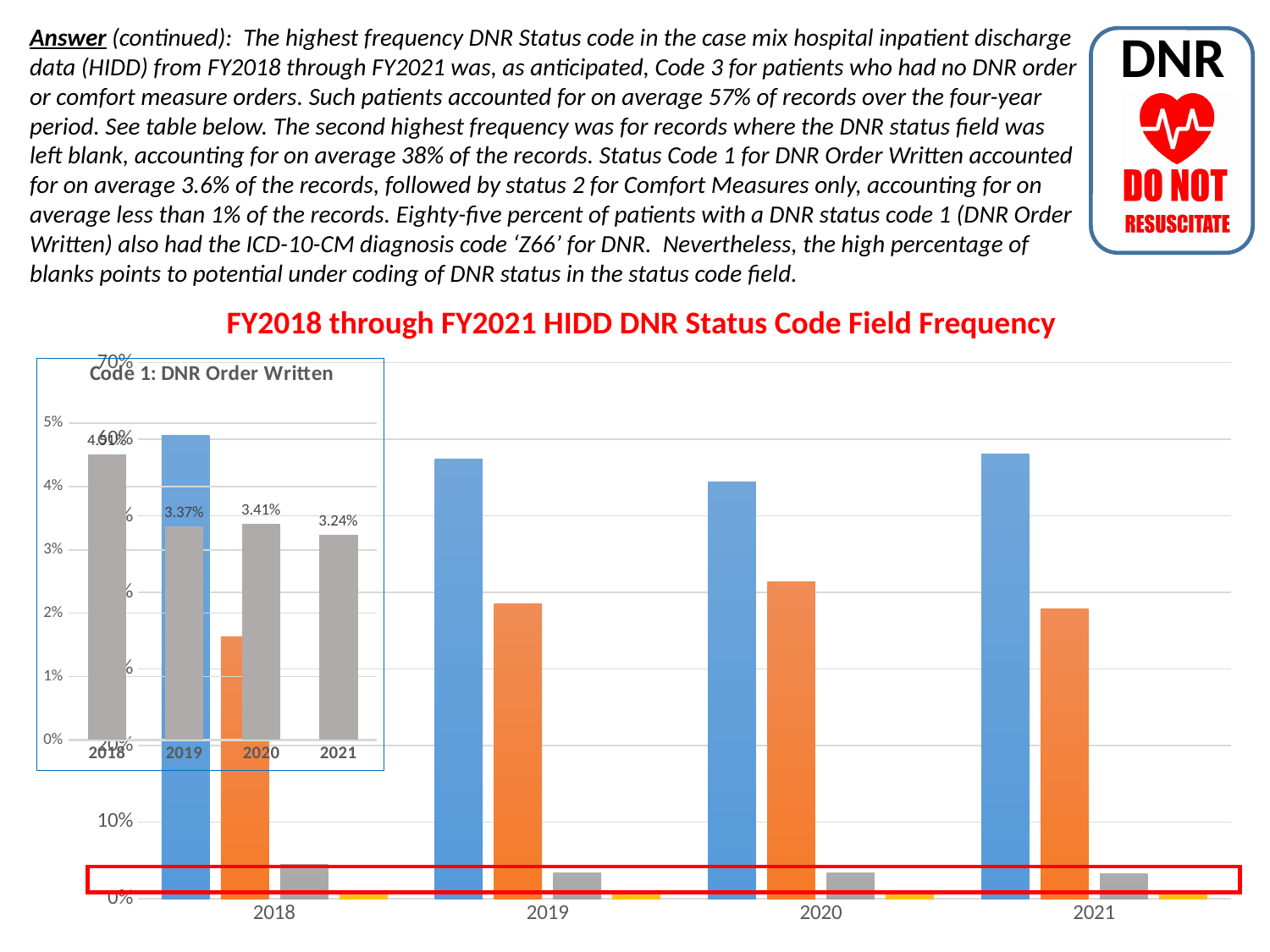
In the inset 'Code 1: DNR Order Written' chart, what is the value for 2021? 3.24% In the large 'HIDD DNR Status Code Field Frequency' chart, how many years are shown on the x axis? 4 What kind of chart is the large 'FY2018 through FY2021 HIDD DNR Status Code Field Frequency' chart? bar chart In the large 'HIDD DNR Status Code Field Frequency' chart, which year has the lowest orange bar? 2018 What is the title of the large chart on the slide? FY2018 through FY2021 HIDD DNR Status Code Field Frequency In the large 'HIDD DNR Status Code Field Frequency' chart, is the orange bar for 2018 greater or less than 40%? less In the inset 'Code 1: DNR Order Written' chart, what is the difference between the 2020 and 2021 values? 0.17% In the inset 'Code 1: DNR Order Written' chart, what is the value for 2019? 3.37% In the large 'HIDD DNR Status Code Field Frequency' chart, is the blue bar for 2020 greater or less than 60%? less In the inset 'Code 1: DNR Order Written' chart, which year has the lowest value? 2021 In the large 'HIDD DNR Status Code Field Frequency' chart, for 2019, which is larger: the blue bar or the orange bar? the blue bar In the large 'HIDD DNR Status Code Field Frequency' chart, which year has the lowest blue bar? 2020